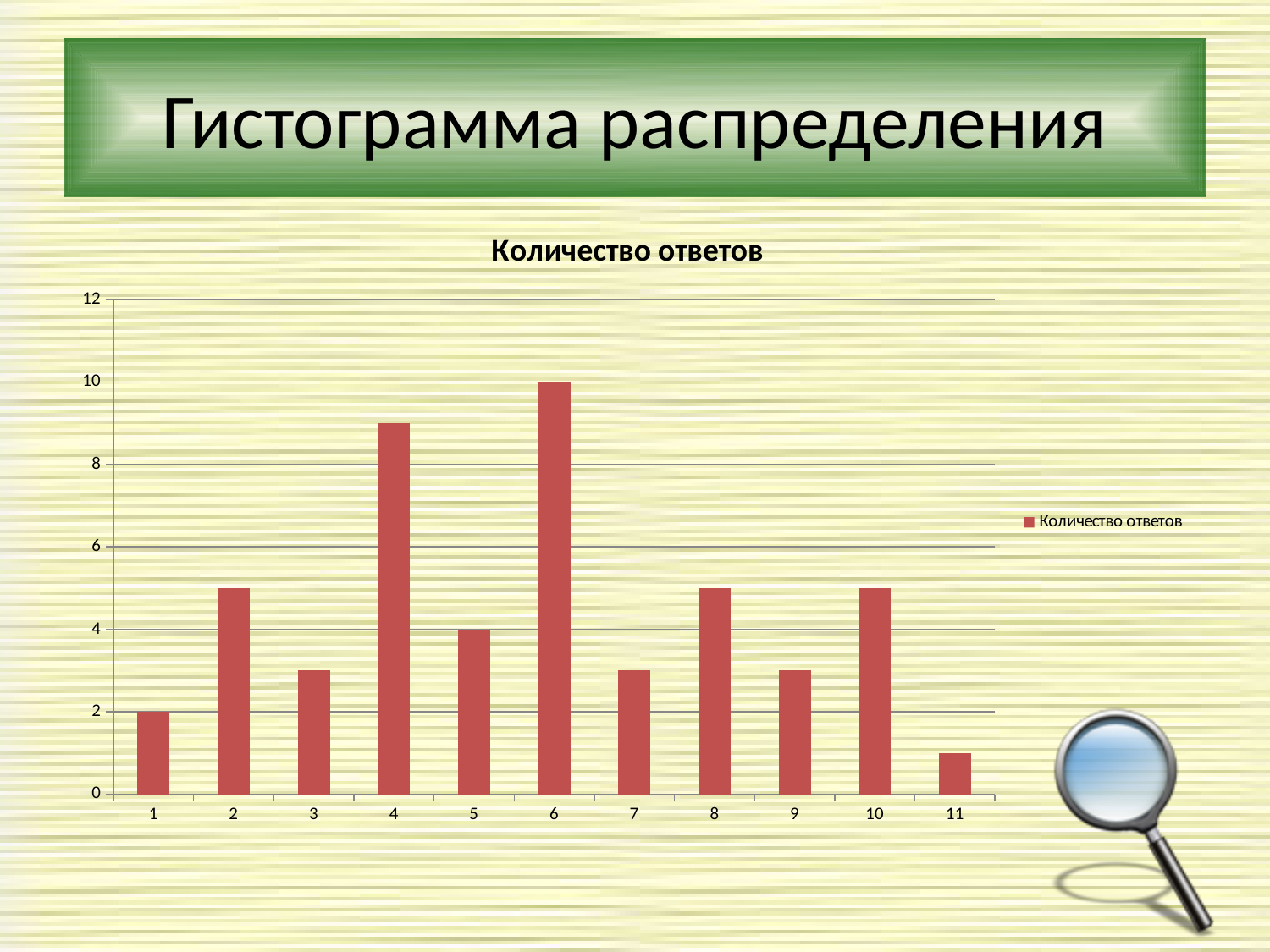
What is the value for category 1? 2 How many series does the legend list? 1 Is the value for category 4 greater or less than 8? greater What type of chart is shown on the slide? bar chart What is the difference between the values for category 6 and category 1? 8 How many categories are shown on the x axis of the chart? 11 Which is larger, the value for category 2 or the value for category 3? 2 Which category has the lowest value? 11 Which category has the highest value? 6 What is the title of the chart? Количество ответов What is the value for category 6? 10 What is the value for category 5? 4